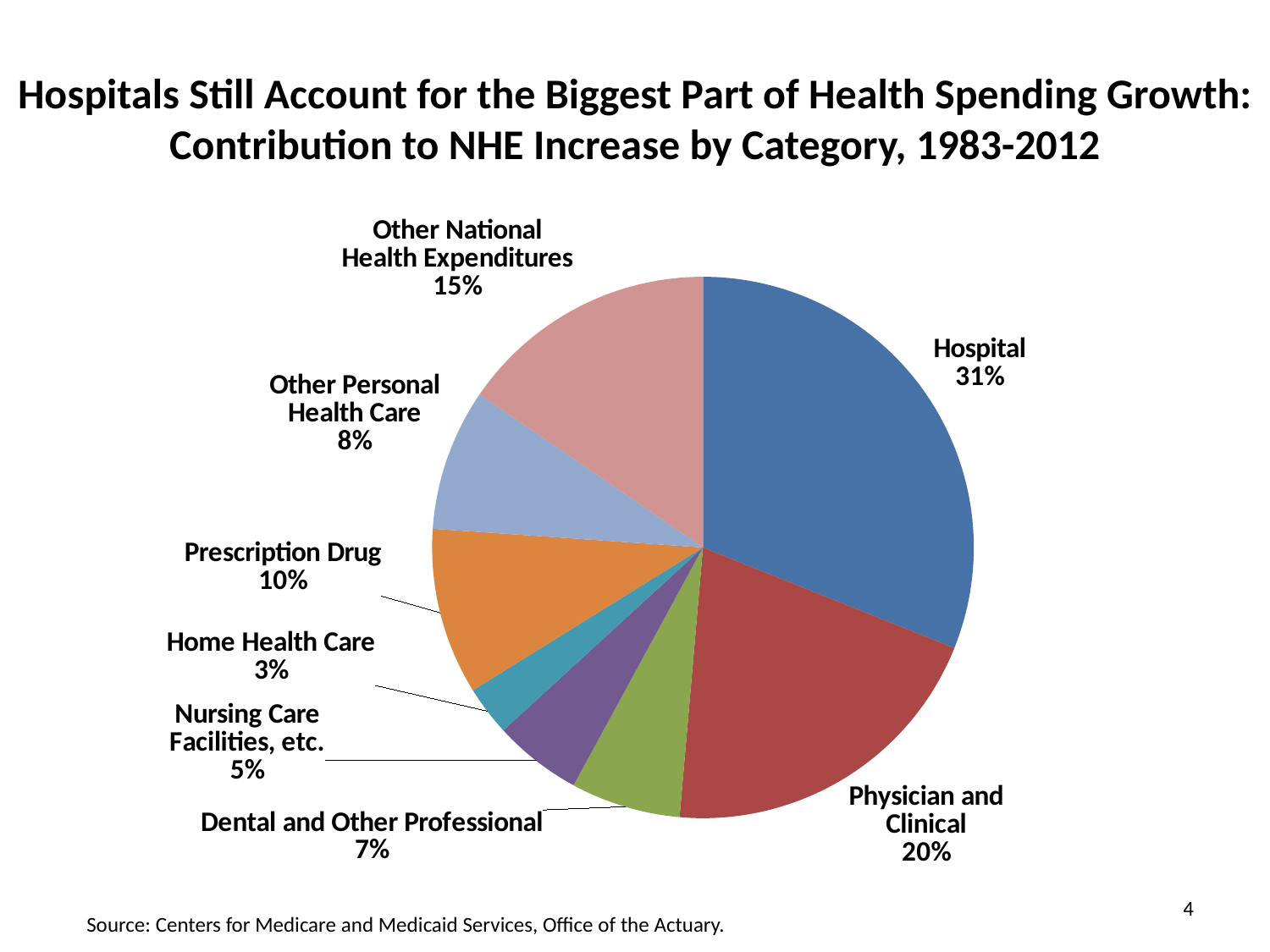
What share of the NHE increase is attributed to Hospital? 31% How many percentage points larger is the Hospital share than the Physician and Clinical share? 11 What is the combined share of Dental and Other Professional and Nursing Care Facilities, etc.? 12% Which is larger, the share for Other National Health Expenditures or the share for Prescription Drug? Other National Health Expenditures What share of the NHE increase is attributed to Physician and Clinical? 20% What share of the NHE increase is attributed to Prescription Drug? 10% How many categories are shown in the pie chart? 8 What share of the NHE increase is attributed to Home Health Care? 3% Which category accounts for the largest share of the NHE increase? Hospital What kind of chart is shown on the slide? Pie chart Which category accounts for the smallest share of the NHE increase? Home Health Care What is the source cited for the chart data? Centers for Medicare and Medicaid Services, Office of the Actuary